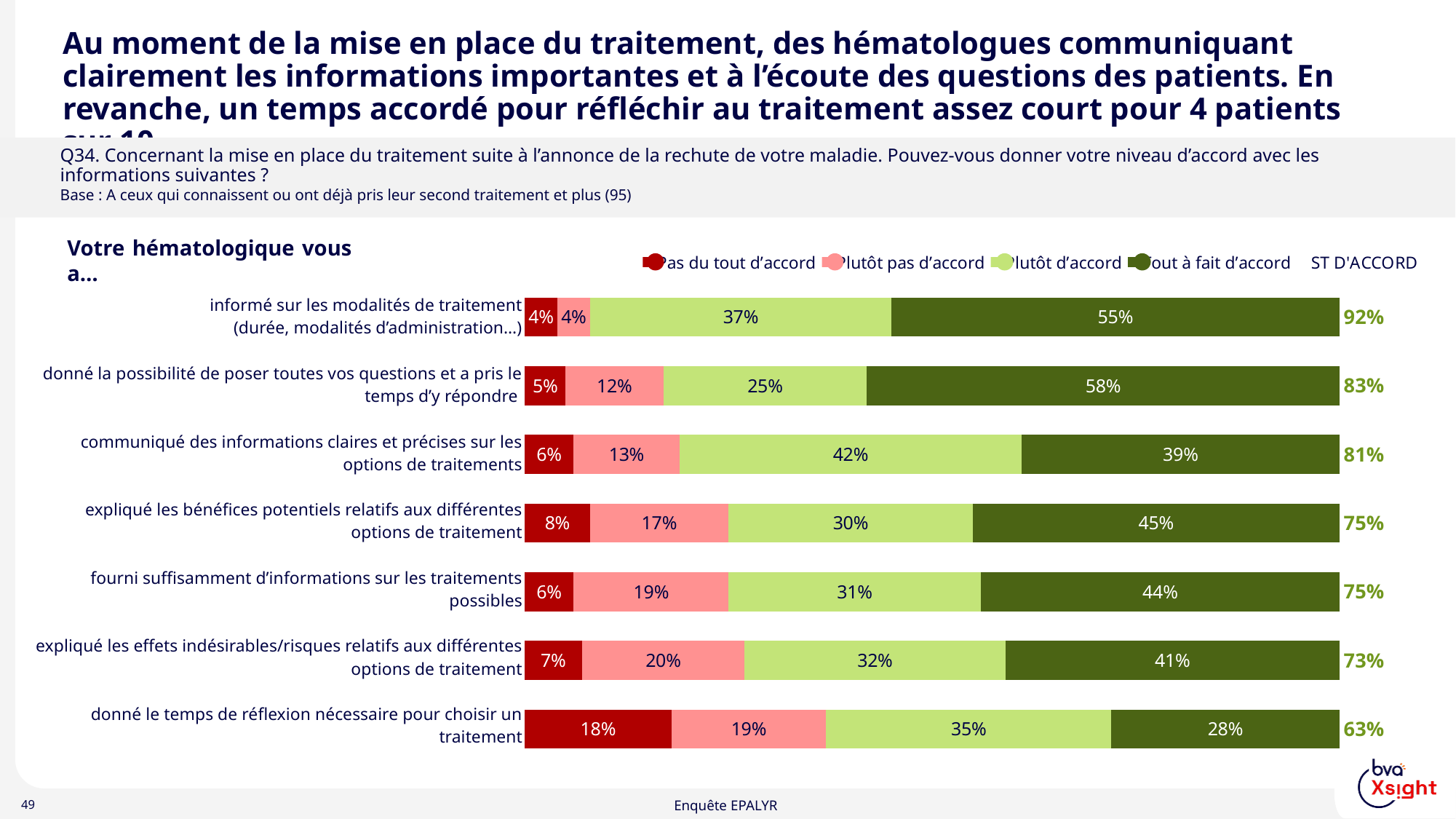
What is the difference in ST D'ACCORD between "informé sur les modalités de traitement" and "donné le temps de réflexion nécessaire pour choisir un traitement"? 29 percentage points What colour represents "Pas du tout d'accord" in the chart? Dark red What is the combined share of "Plutôt d'accord" and "Tout à fait d'accord" for "expliqué les effets indésirables/risques relatifs aux différentes options de traitement"? 73% What is the "Plutôt pas d'accord" value for "fourni suffisamment d'informations sur les traitements possibles"? 19% Which has a larger "Plutôt d'accord" share: "communiqué des informations claires et précises sur les options de traitements" or "expliqué les bénéfices potentiels relatifs aux différentes options de traitement"? communiqué des informations claires et précises sur les options de traitements What kind of chart is shown on the slide? Stacked bar chart Which item has the lowest ST D'ACCORD value? donné le temps de réflexion nécessaire pour choisir un traitement What percentage of respondents answered "Tout à fait d'accord" for "donné la possibilité de poser toutes vos questions et a pris le temps d'y répondre"? 58% Which item has the highest "Tout à fait d'accord" percentage? donné la possibilité de poser toutes vos questions et a pris le temps d'y répondre How many items (bars) are shown in the chart? 7 How many series does the legend list? 4 What percentage answered "Pas du tout d'accord" for "donné le temps de réflexion nécessaire pour choisir un traitement"? 18%